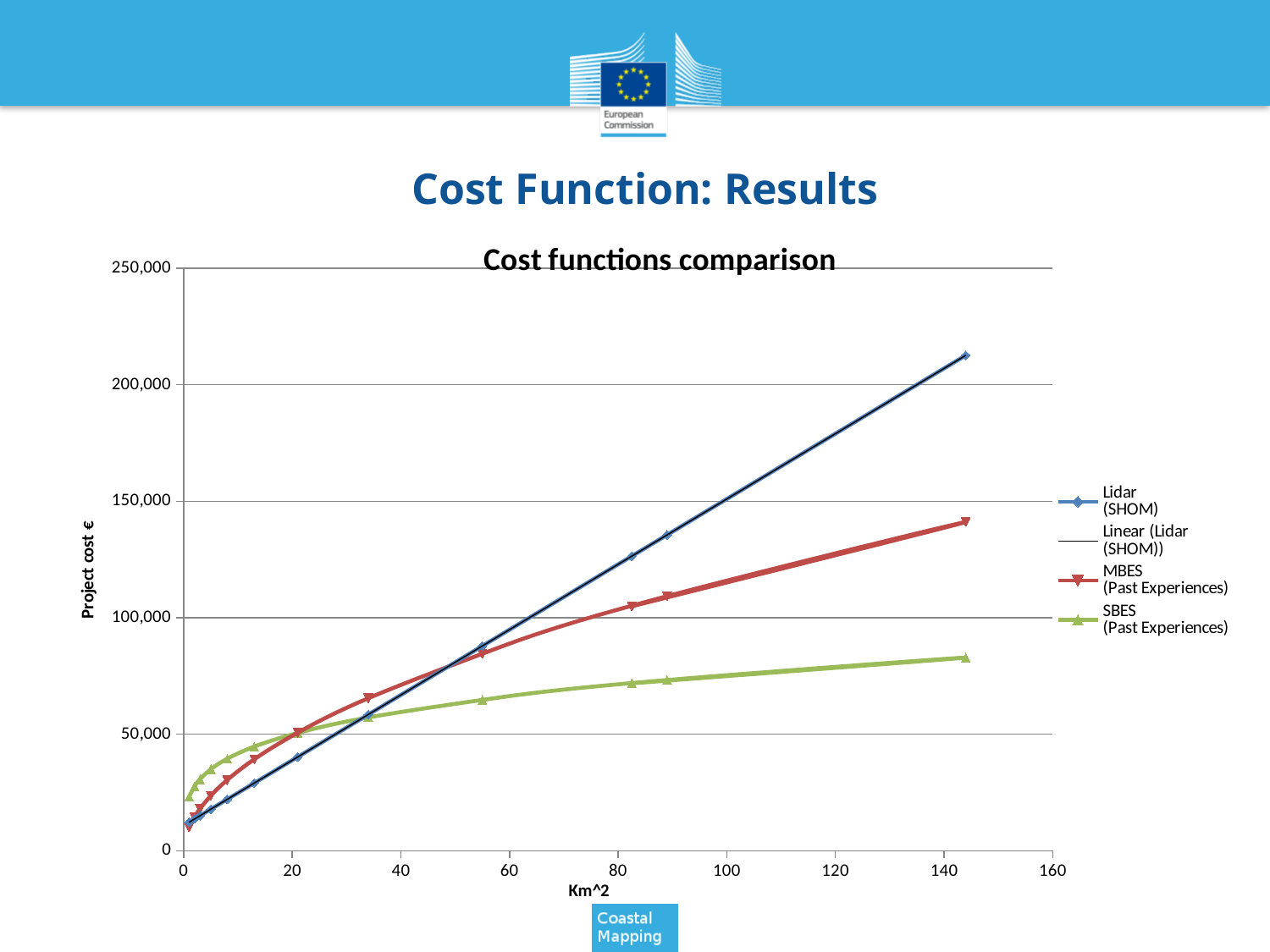
Is the value for Lidar (SHOM) at its last point (around 144 Km^2) greater or less than 200,000? greater At around 144 Km^2, which is larger: the cost for Lidar (SHOM) or for SBES (Past Experiences)? Lidar (SHOM) Which series reaches the highest project cost at the right end of the chart? Lidar (SHOM) How many series does the legend list? 4 What is the title of the chart? Cost functions comparison Is the value for MBES (Past Experiences) at its last point (around 144 Km^2) greater or less than 150,000? less What type of chart is shown on the slide? Line chart At around 5 Km^2, which is larger: the cost for SBES (Past Experiences) or for Lidar (SHOM)? SBES (Past Experiences) Do the project cost values for MBES (Past Experiences) rise or fall as Km^2 increases? Rise Is the value for SBES (Past Experiences) at its last point (around 144 Km^2) greater or less than 100,000? less What is the label of the x axis? Km^2 Which series has the lowest project cost at the right end of the chart (around 144 Km^2)? SBES (Past Experiences)